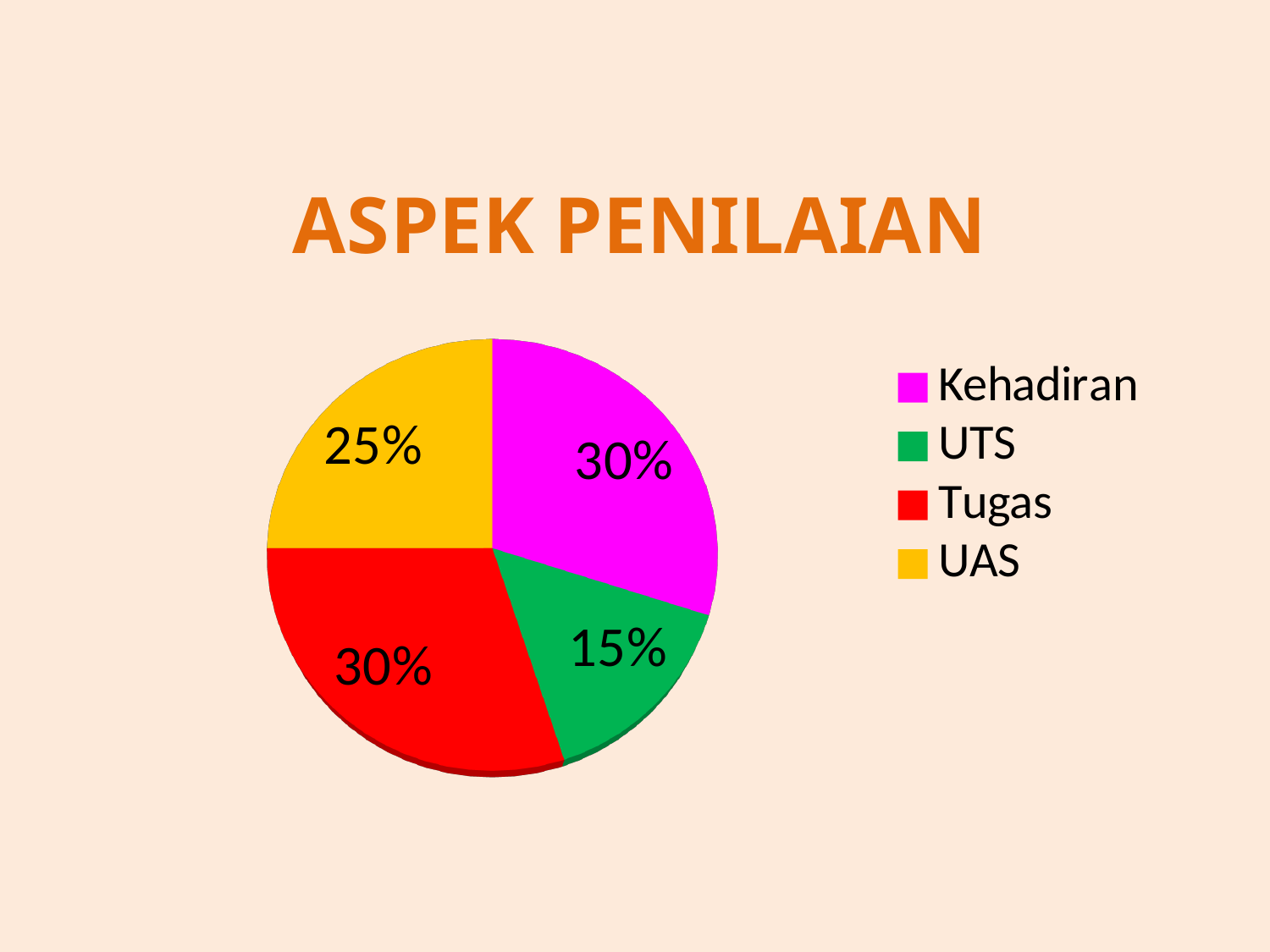
What is the share for UTS? 15% What kind of chart is shown on the slide? pie chart What is the title of the chart? ASPEK PENILAIAN How many categories does the pie chart show? 4 Which is larger, the share for UAS or the share for UTS? UAS What is the share for UAS? 25% Which category has the smallest share of the pie? UTS What is the share for Kehadiran? 30% What is the share for Tugas? 30% What is the difference between the shares of UAS and UTS? 10% What is the difference between the shares of Kehadiran and UAS? 5% Which colour represents Tugas in the pie chart? red